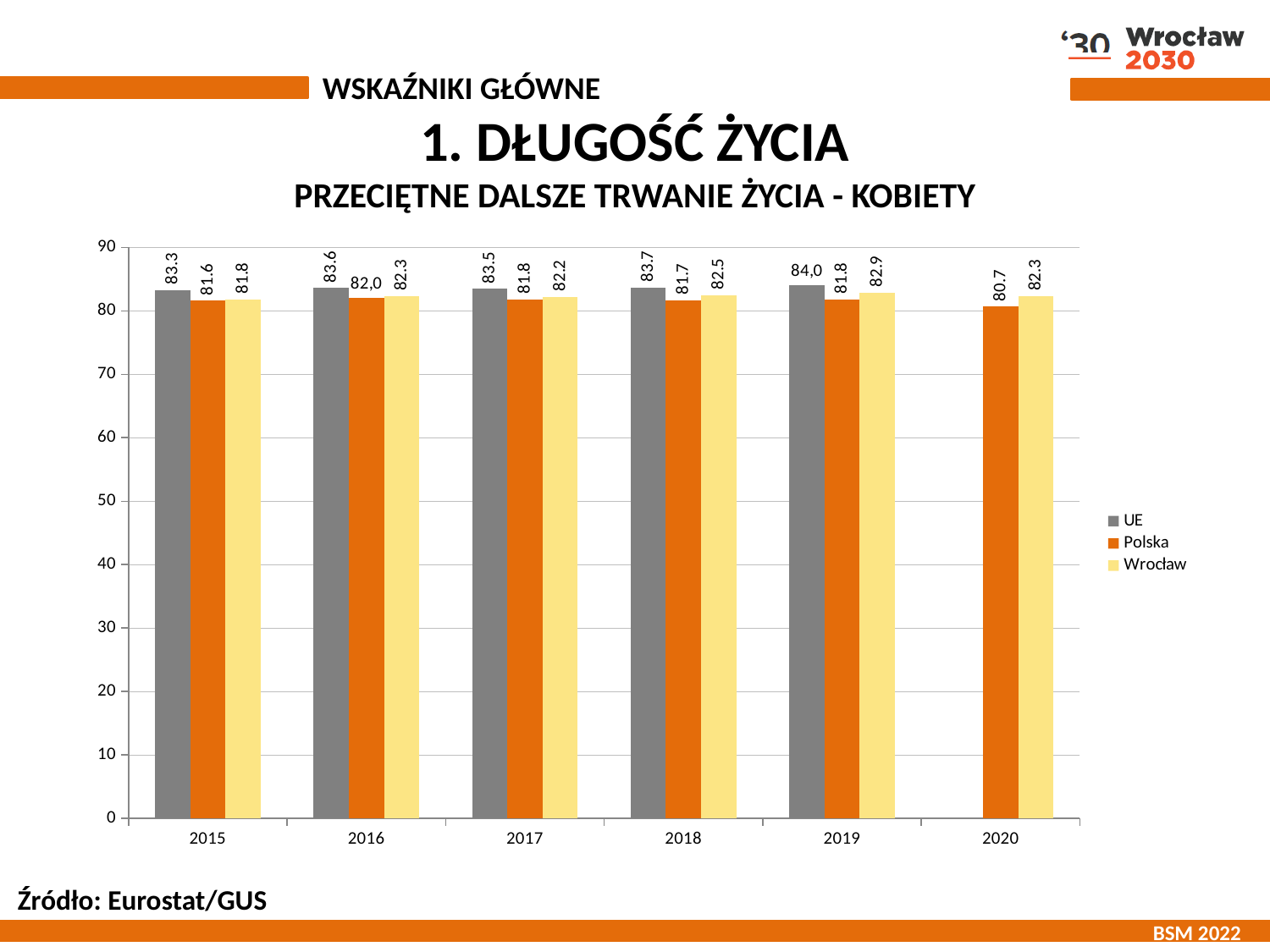
How many years are shown on the x axis? 6 What is the value for UE in 2019? 84,0 In which year is the Polska value lowest? 2020 How many series does the legend list? 3 Which series is shown in grey in the legend? UE Which is larger in 2015: the UE value or the Wrocław value? UE What type of chart is shown on the slide? bar chart What is the value for Wrocław in 2018? 82.5 In which year is the Wrocław value highest? 2019 What is the value for Polska in 2016? 82,0 What is the value for Polska in 2020? 80.7 What is the difference between the Wrocław and Polska values in 2020? 1.6